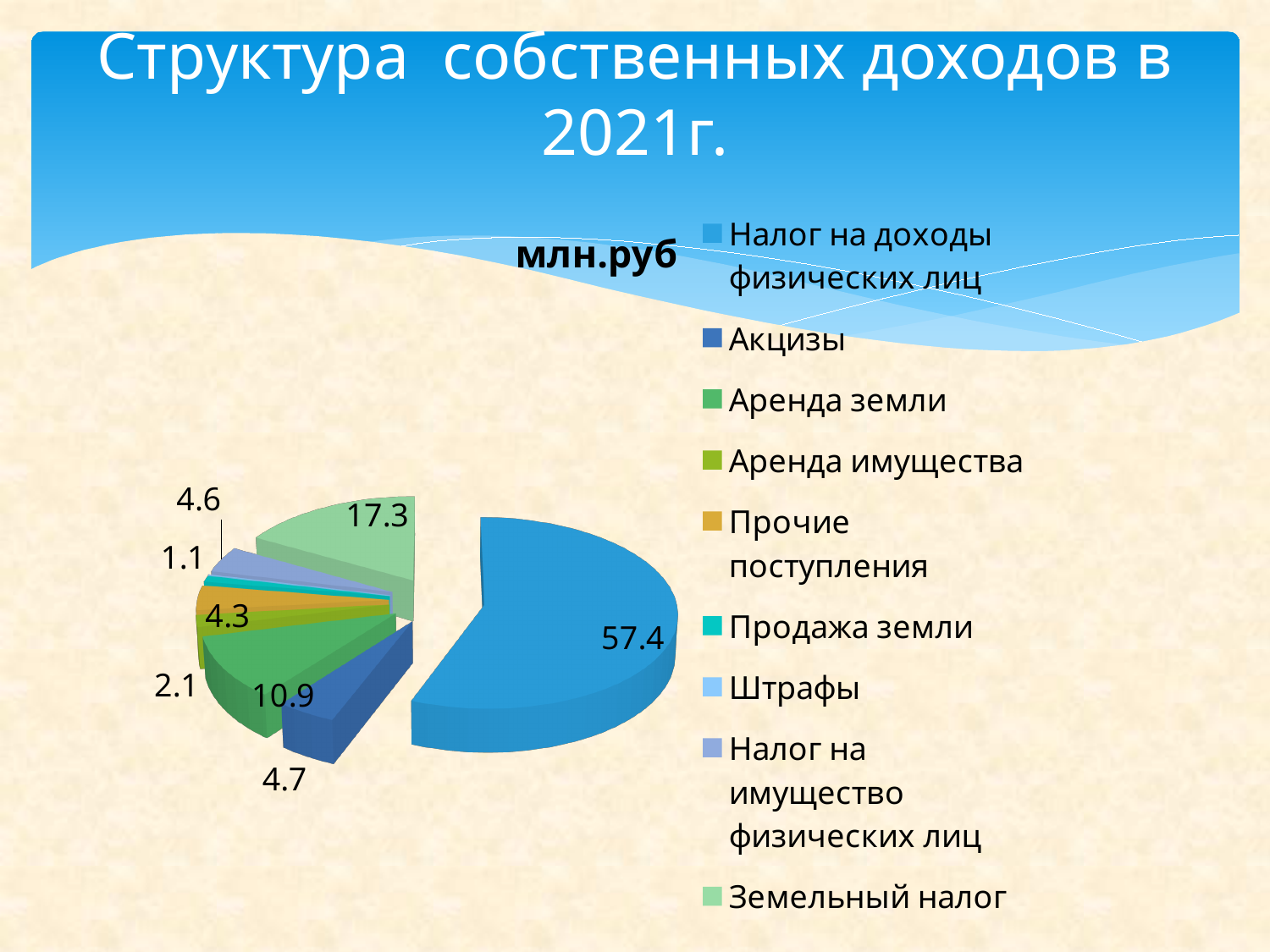
Which is larger, the value for Аренда земли or the value for Акцизы? Аренда земли What is the value for Налог на доходы физических лиц? 57.4 What is the value for Земельный налог? 17.3 What is the value for Аренда имущества? 2.1 What is the value for Прочие поступления? 4.3 How many categories does the legend list? 9 What is the value for Аренда земли? 10.9 What is the difference between the values for Налог на доходы физических лиц and Земельный налог? 40.1 Which category has the largest slice of the pie? Налог на доходы физических лиц What is the title of the chart? млн.руб What type of chart is shown on the slide? pie chart What is the value for Акцизы? 4.7